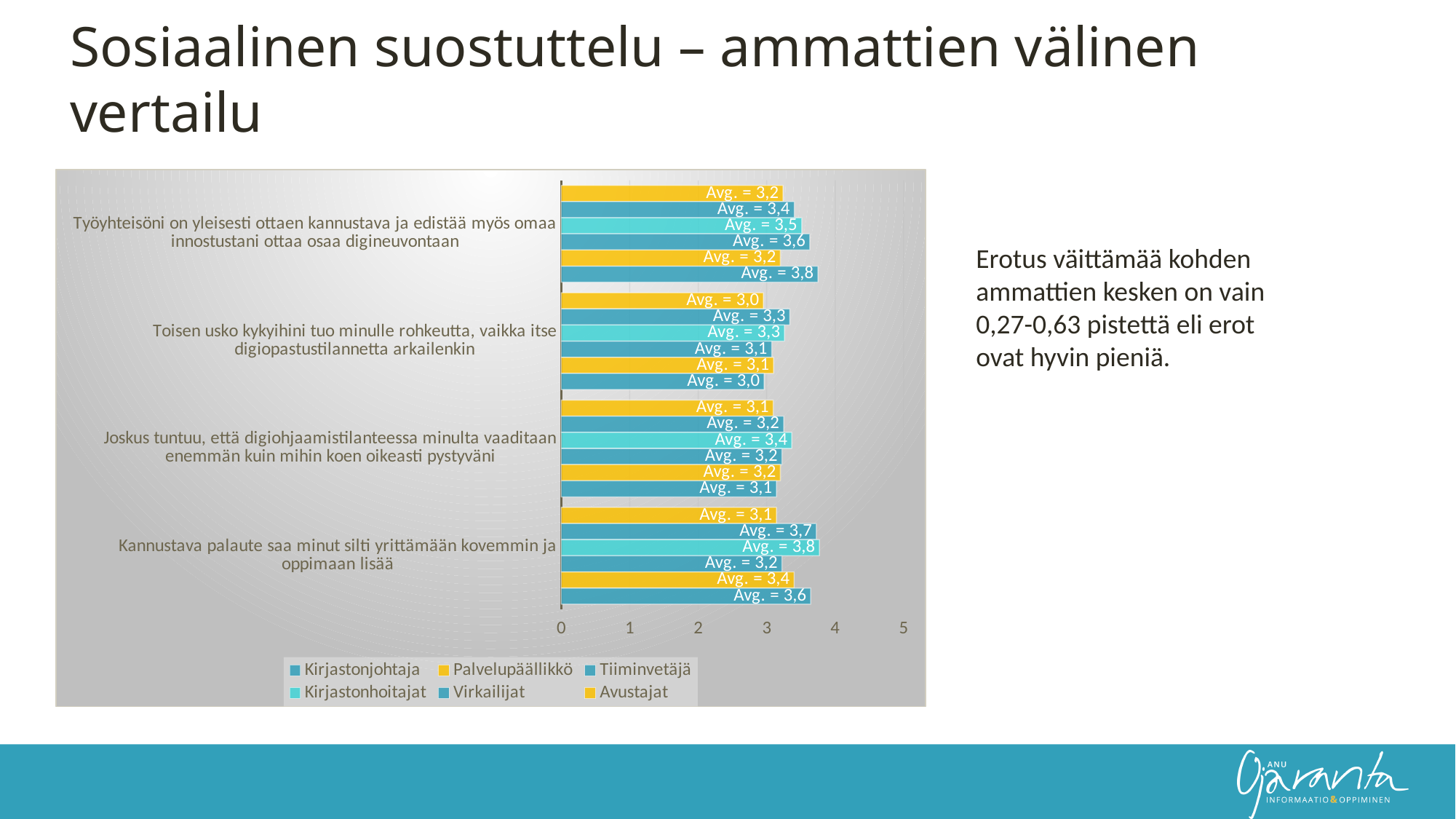
Is the Kirjastonhoitajat value for "Työyhteisöni on yleisesti ottaen kannustava ja edistää myös omaa innostustani ottaa osaa digineuvontaan" greater or less than 4? less Which series has the highest value for the statement "Kannustava palaute saa minut silti yrittämään kovemmin ja oppimaan lisää"? Kirjastonhoitajat What is the lowest value shown for the statement "Kannustava palaute saa minut silti yrittämään kovemmin ja oppimaan lisää"? 3,1 What is the maximum value shown on the chart's horizontal axis? 5 How many series does the chart legend list? 6 What kind of chart is shown on the slide? bar chart What is the value for Kirjastonhoitajat for the statement "Toisen usko kykyihini tuo minulle rohkeutta, vaikka itse digiopastustilannetta arkailenkin"? Avg. = 3,3 What is the value for Kirjastonhoitajat for the statement "Joskus tuntuu, että digiohjaamistilanteessa minulta vaaditaan enemmän kuin mihin koen oikeasti pystyväni"? Avg. = 3,4 How many statements (categories) are compared in the chart? 4 What is the value for Kirjastonhoitajat for the statement "Kannustava palaute saa minut silti yrittämään kovemmin ja oppimaan lisää"? Avg. = 3,8 What is the difference between the Kirjastonhoitajat values for "Kannustava palaute saa minut silti yrittämään kovemmin ja oppimaan lisää" and "Toisen usko kykyihini tuo minulle rohkeutta, vaikka itse digiopastustilannetta arkailenkin"? 0,5 What is the highest value shown for the statement "Työyhteisöni on yleisesti ottaen kannustava ja edistää myös omaa innostustani ottaa osaa digineuvontaan"? 3,8